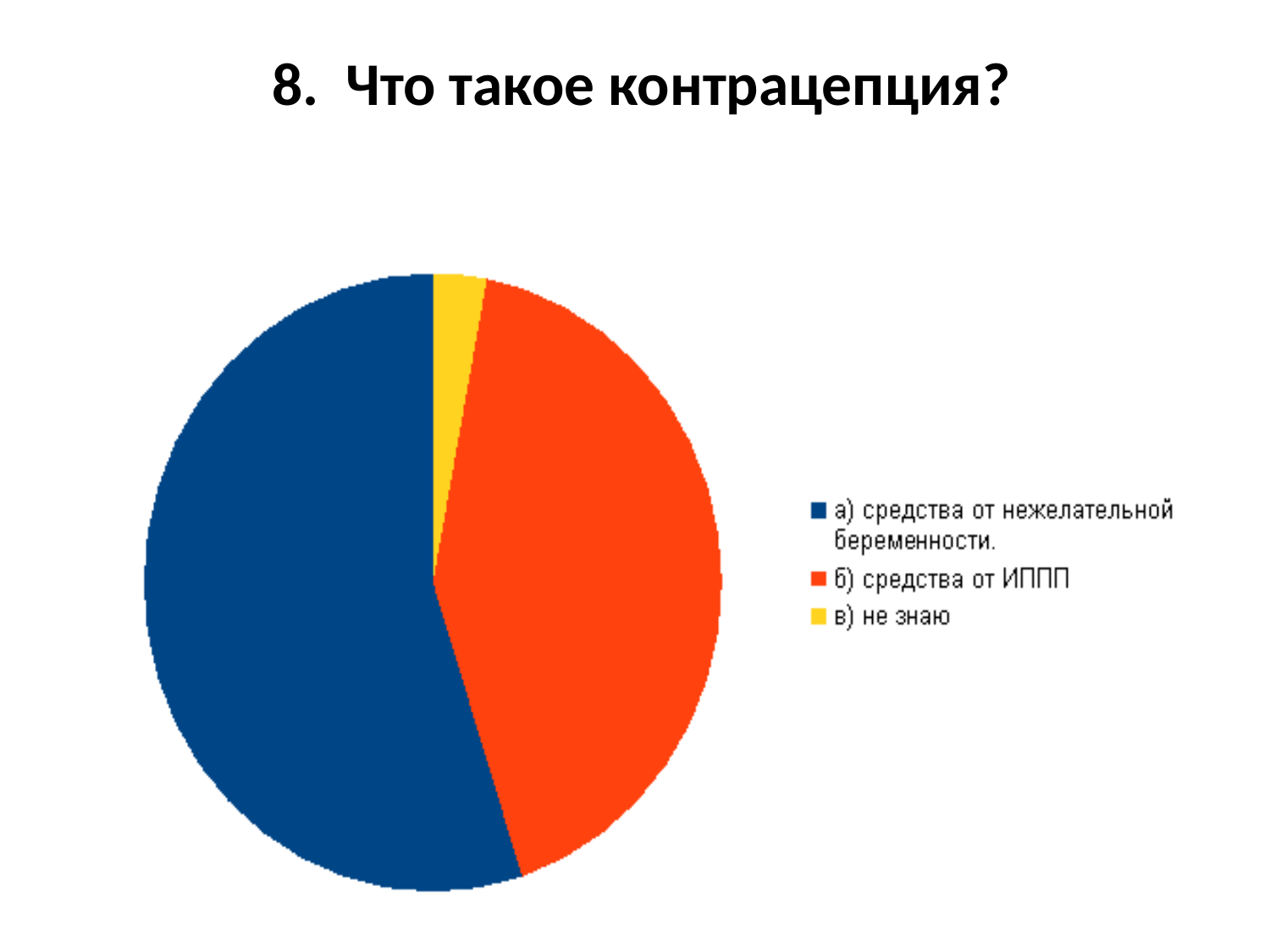
How many slices does the pie chart have? 3 What is the title of the slide containing the pie chart? 8. Что такое контрацепция? What colour is the slice for "в) не знаю" in the pie chart? yellow Which slice is larger: "б) средства от ИППП" or "в) не знаю"? б) средства от ИППП Which slice is larger: "а) средства от нежелательной беременности." or "б) средства от ИППП"? а) средства от нежелательной беременности. Which category has the smallest slice of the pie chart? в) не знаю Which category has the largest slice of the pie chart? а) средства от нежелательной беременности. How many entries does the legend of the pie chart list? 3 What kind of chart is shown on the slide? pie chart